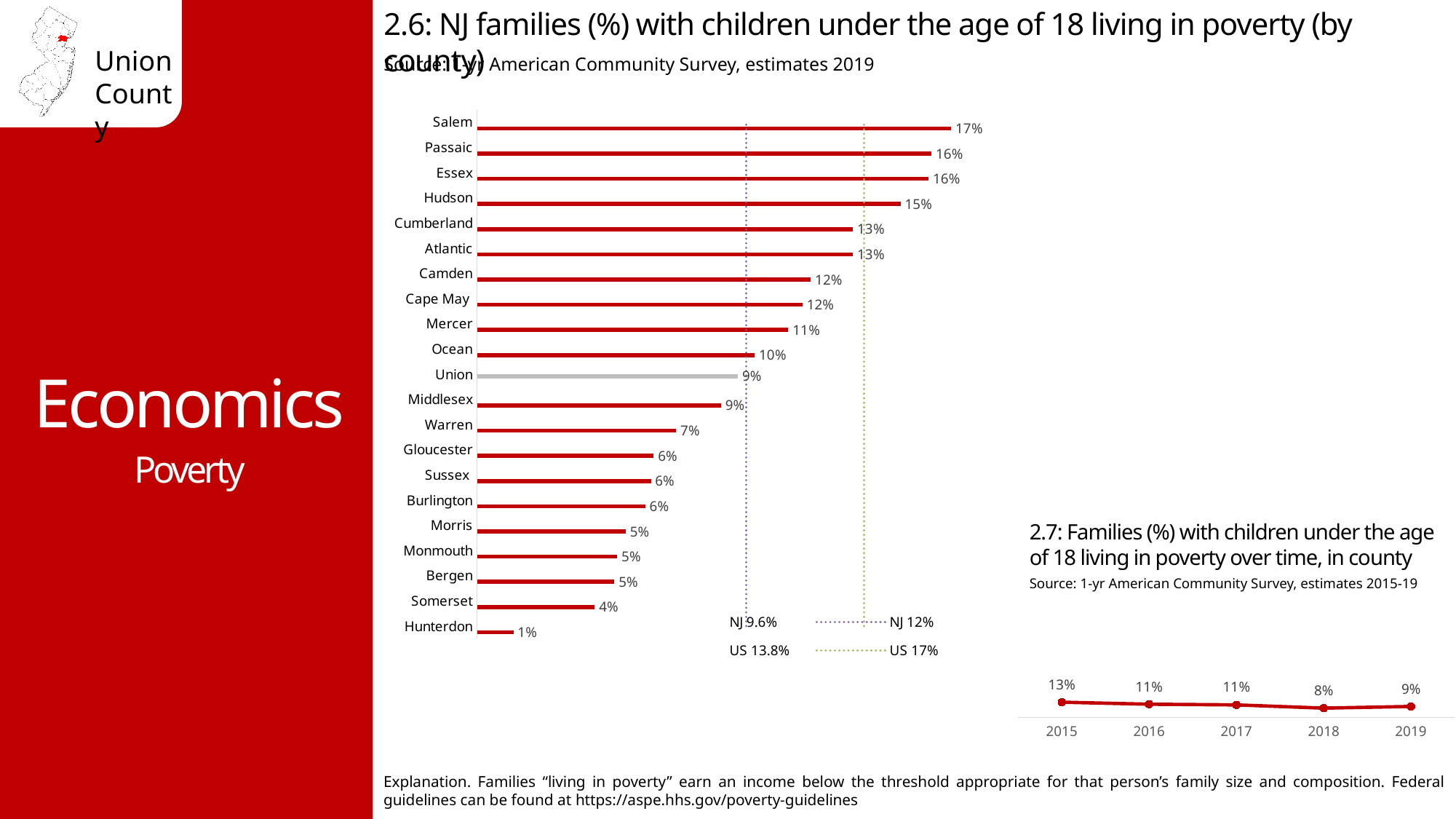
In chart 2.7, how many years are plotted? 5 In chart 2.6, which has the larger value, Mercer or Warren? Mercer In chart 2.6 (NJ families with children under 18 living in poverty by county), what is the value for Salem? 17% In chart 2.6, which county has the lowest value? Hunterdon In chart 2.6, what is the difference between the values for Hudson and Somerset? 11% In chart 2.6, how many counties are plotted? 21 In chart 2.7 (families in poverty over time, in county), what is the value for 2018? 8% In chart 2.6, what is the value for Union? 9% What kind of chart is chart 2.6? Bar chart In chart 2.7, which year has the highest value? 2015 In chart 2.7, what is the difference between the values for 2015 and 2019? 4% In chart 2.6, which county has the highest value? Salem